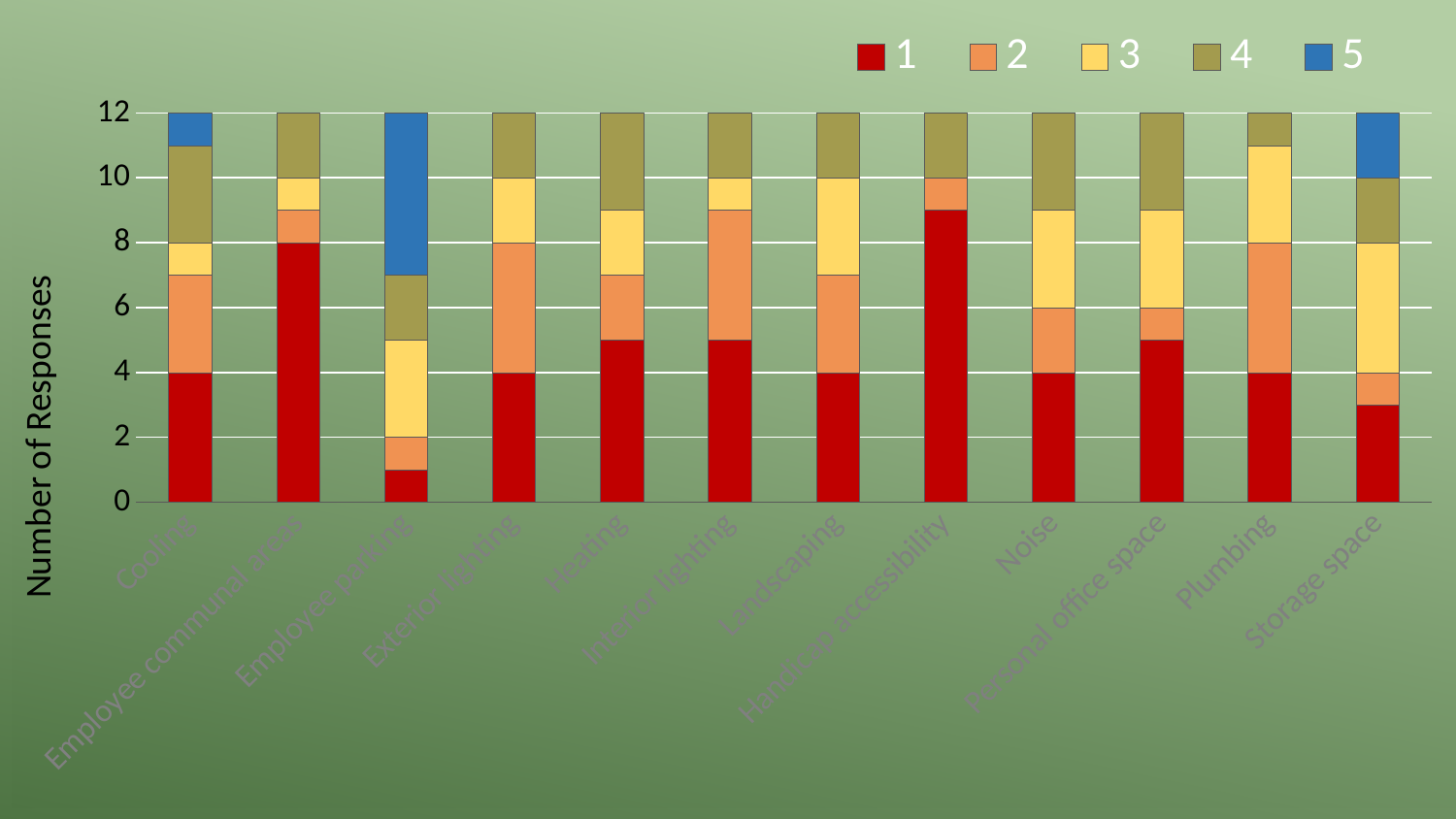
Is the value of series 1 for Storage space greater or less than 4? less How many series does the legend list? 5 Which category has the highest value for series 1? Handicap accessibility Is the value of series 1 for Handicap accessibility greater or less than 8? greater Which is larger for series 1: Cooling or Employee communal areas? Employee communal areas Which category has the lowest value for series 1? Employee parking What is the total height of the stacked bar for Noise? 12 What is the title of the vertical axis? Number of Responses How many categories are shown along the x axis? 12 What kind of chart is shown on the slide? Stacked bar chart What is the value of series 1 for Cooling? 4 What is the value of series 1 for Employee communal areas? 8